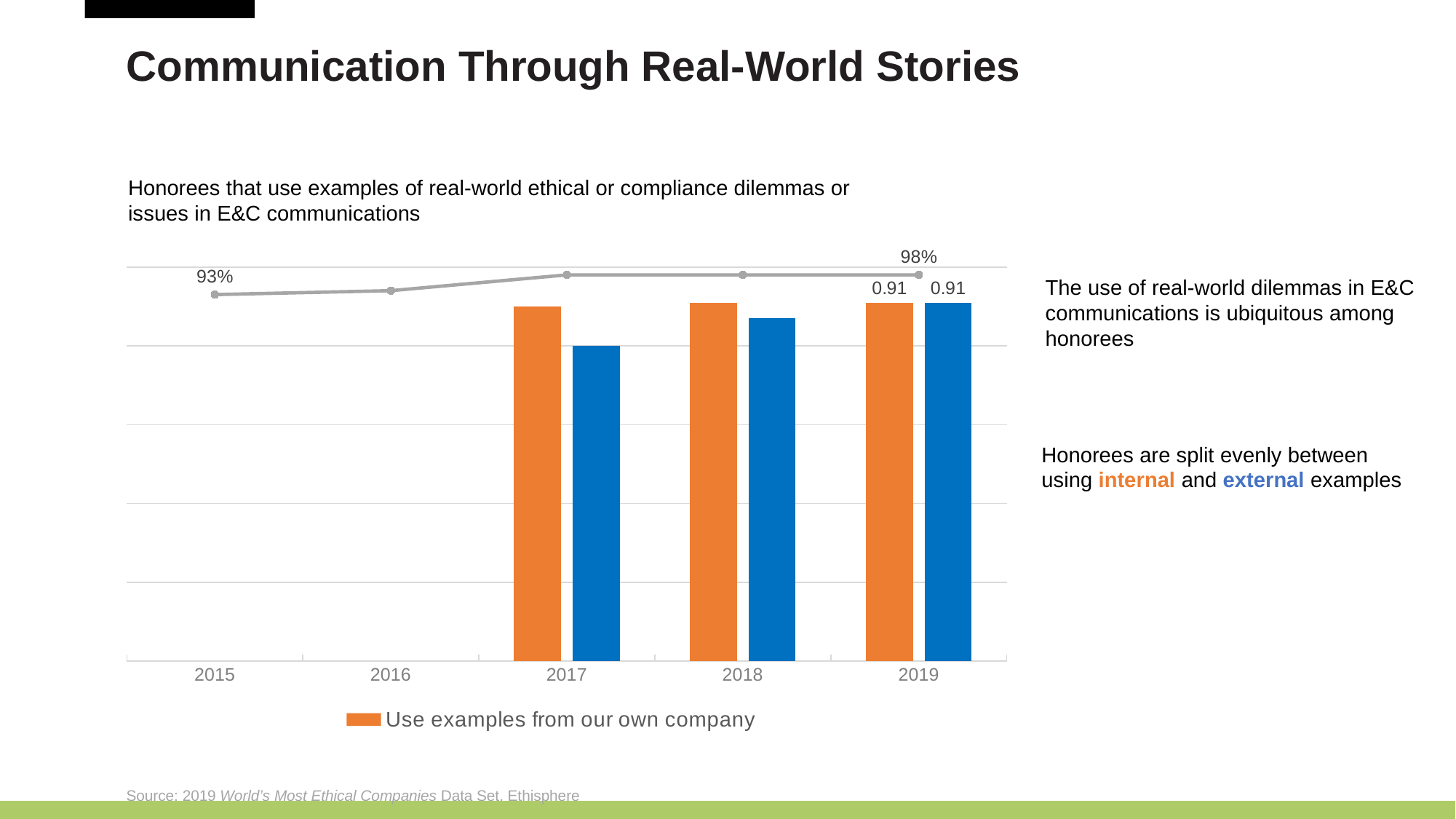
What series name is shown in the legend? Use examples from our own company How many years have bars plotted? 3 What is the value of the orange bar (Use examples from our own company) for 2019? 0.91 What is the value of the blue bar for 2019? 0.91 Among the years with blue bars, which year has the shortest blue bar? 2017 Which year has the lowest value on the grey line? 2015 Does the grey line rise or fall from 2015 to 2019? Rise What is the value of the grey line for 2019? 98% In 2017, which bar is taller, the orange bar or the blue bar? The orange bar How many years are shown on the x axis? 5 What is the value of the grey line for 2015? 93% By how many percentage points does the grey line value for 2019 exceed the value for 2015? 5 percentage points